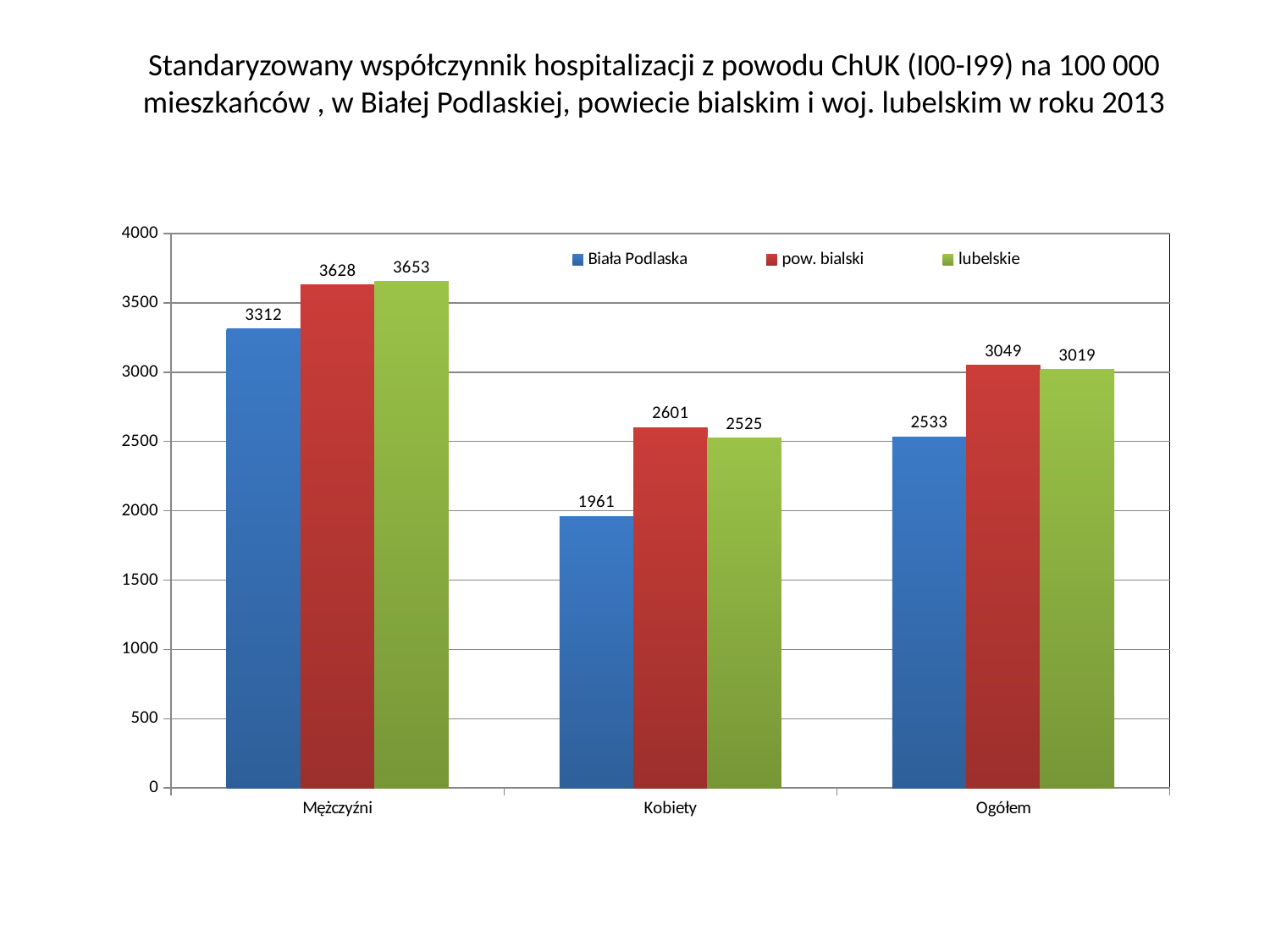
How many categories are shown on the x axis? 3 What is the difference between the pow. bialski and Biała Podlaska values in the Kobiety category? 640 Which series has the lowest value in the Kobiety category? Biała Podlaska What is the value for Biała Podlaska in the Mężczyźni category? 3312 Is the value for Biała Podlaska in the Ogółem category greater or less than 3000? less How many series does the legend list? 3 What kind of chart is shown on the slide? bar chart What is the value for pow. bialski in the Kobiety category? 2601 Which is larger: the pow. bialski value for Ogółem or the lubelskie value for Ogółem? pow. bialski What is the value for lubelskie in the Ogółem category? 3019 Which colour represents the pow. bialski series? red Which series has the highest value in the Mężczyźni category? lubelskie